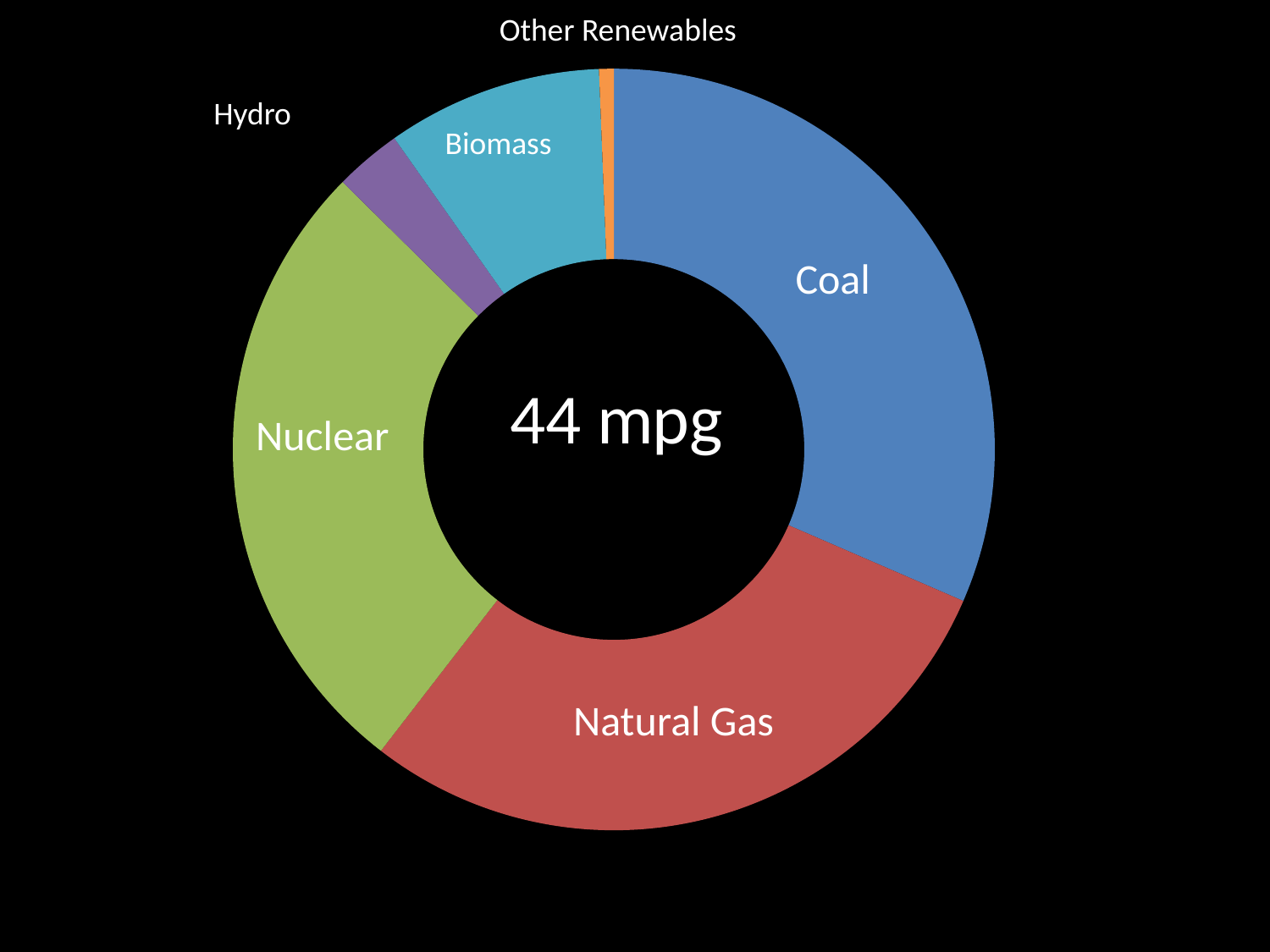
How many categories does the chart show? 6 Which slice is larger, Nuclear or Biomass? Nuclear What kind of chart is shown on the slide? Doughnut (pie) chart What text is shown in the centre of the doughnut chart? 44 mpg What colour is the Nuclear slice? Green Which slice is larger, Biomass or Hydro? Biomass Which slice is larger, Coal or Natural Gas? Coal Which category has the largest slice in the chart? Coal Which category has the smallest slice in the chart? Other Renewables